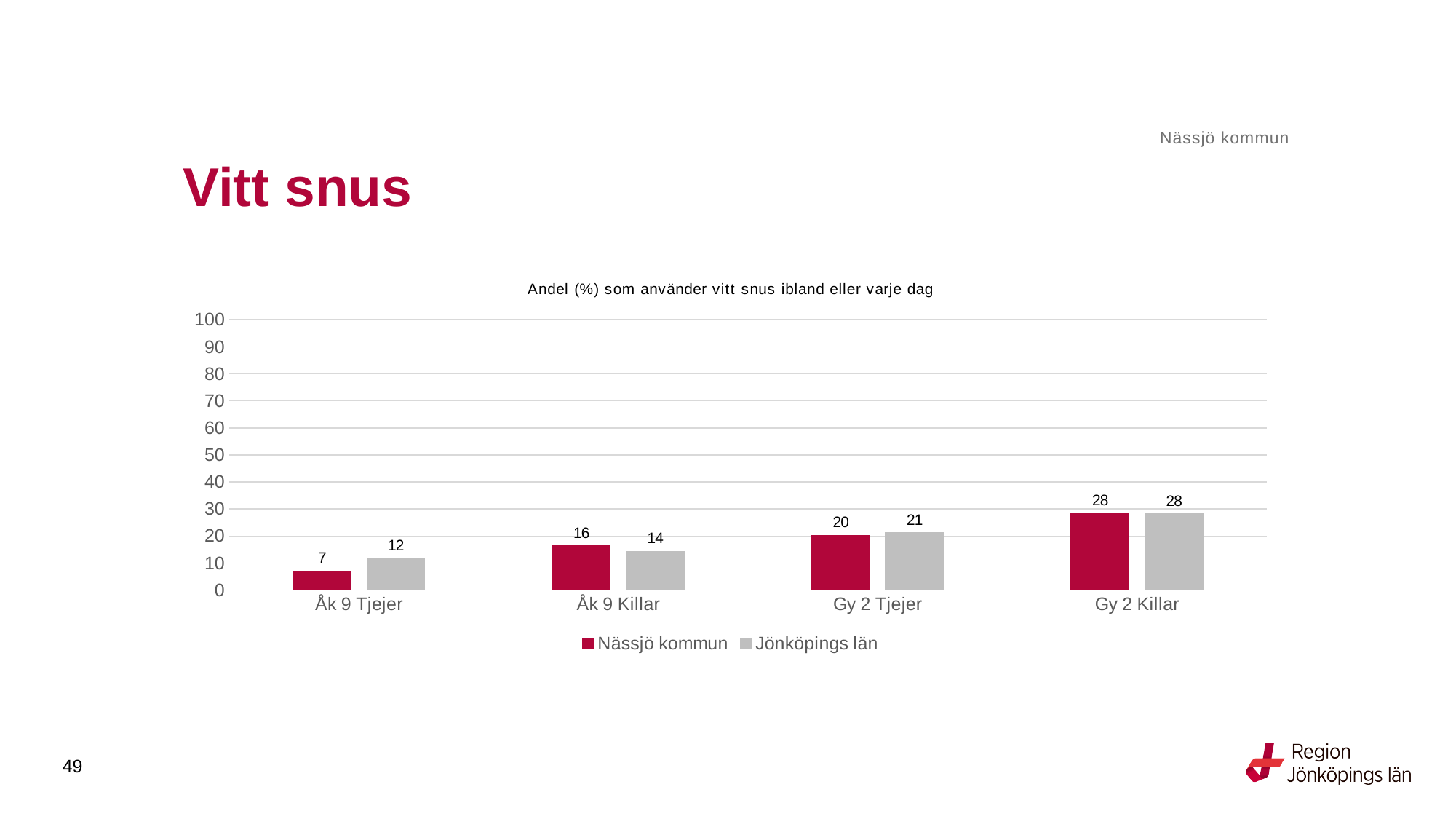
How many categories are shown on the x axis? 4 Which category has the lowest value for Jönköpings län? Åk 9 Tjejer What is the value for Nässjö kommun in the Åk 9 Tjejer category? 7 How many series does the legend list? 2 Which category has the highest value for Nässjö kommun? Gy 2 Killar What is the difference between the Jönköpings län and Nässjö kommun values for Åk 9 Tjejer? 5 What is the value for Jönköpings län in the Gy 2 Tjejer category? 21 Which is larger for Åk 9 Killar: Nässjö kommun or Jönköpings län? Nässjö kommun Is the value for Nässjö kommun in Gy 2 Killar greater or less than 20? greater What is the value for Nässjö kommun in the Åk 9 Killar category? 16 What is the title of the chart? Andel (%) som använder vitt snus ibland eller varje dag What kind of chart is shown on the slide? Bar chart